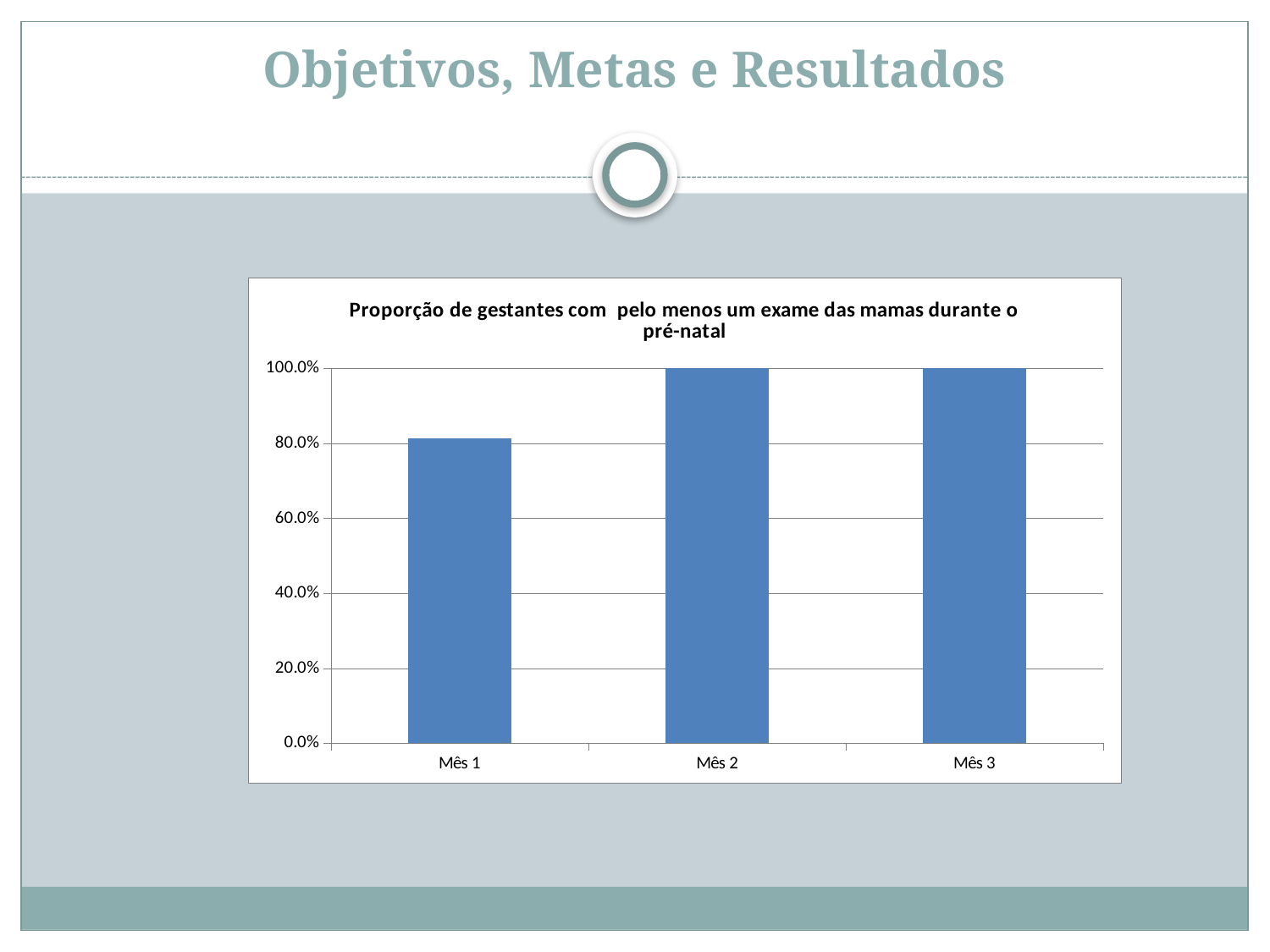
Is the value for Mês 1 greater or less than 60.0%? greater What is the value for Mês 3? 100.0% What is the title of the chart? Proporção de gestantes com pelo menos um exame das mamas durante o pré-natal What is the highest value shown on the y axis of the chart? 100.0% Which is larger, the value for Mês 1 or the value for Mês 2? Mês 2 Do the values rise or fall from Mês 1 to Mês 2? rise Which month has the lowest value? Mês 1 How many categories are shown on the x axis of the chart? 3 What kind of chart is shown on the slide? bar chart What is the value for Mês 2? 100.0% Is the value for Mês 1 greater or less than 100.0%? less